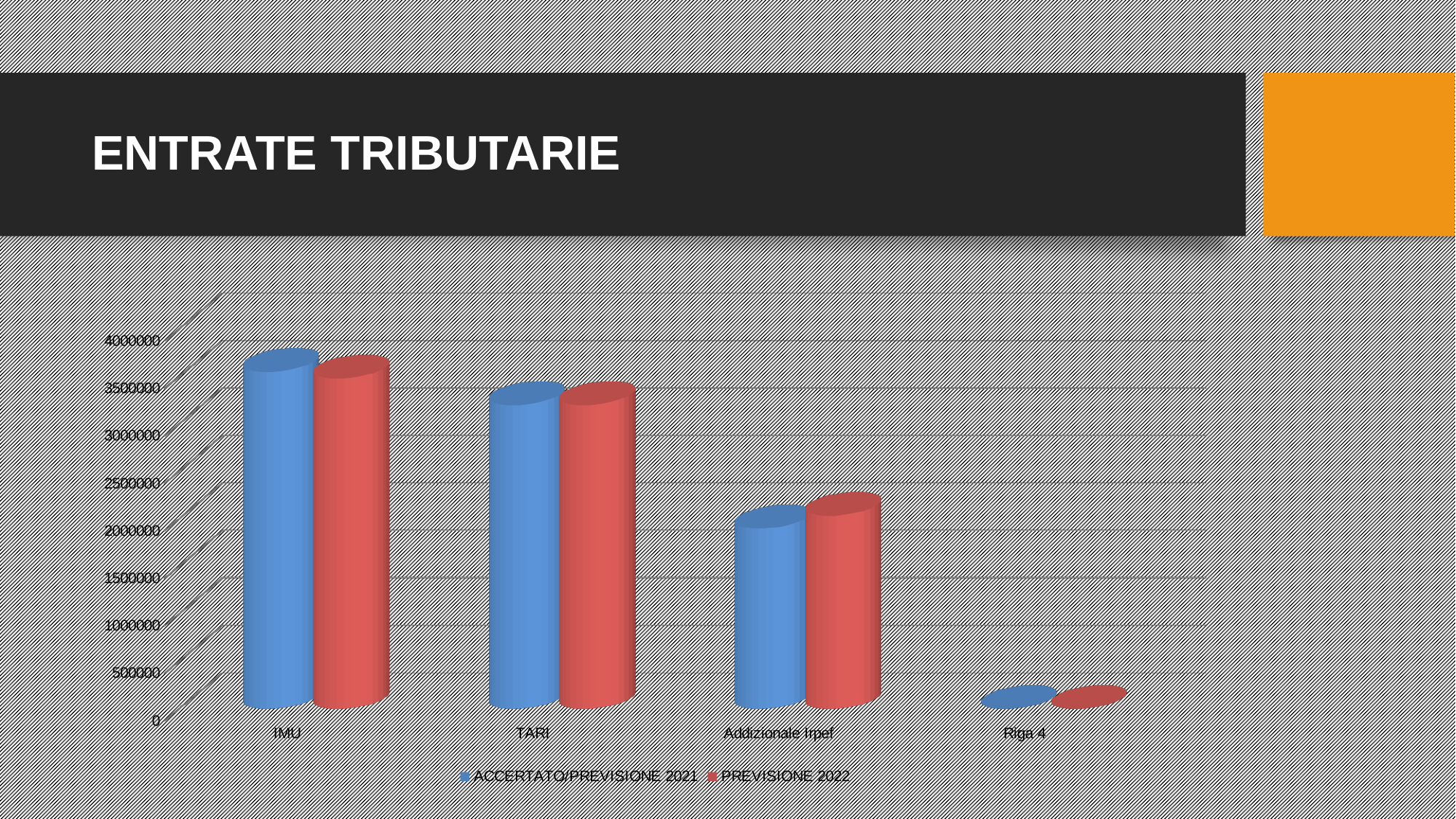
Is the PREVISIONE 2022 value for TARI greater or less than 3000000? greater Is the ACCERTATO/PREVISIONE 2021 value for Addizionale Irpef greater or less than 2500000? less Which category has the highest value for the ACCERTATO/PREVISIONE 2021 series? IMU What kind of chart is shown on the slide? bar chart How many categories are shown on the x axis of the chart? 4 Which category has the lowest value for the PREVISIONE 2022 series? Riga 4 Is the PREVISIONE 2022 value for Addizionale Irpef greater or less than 1500000? greater For the ACCERTATO/PREVISIONE 2021 series, which is larger: IMU or Addizionale Irpef? IMU Which colour represents the ACCERTATO/PREVISIONE 2021 series in the chart? blue What is the title of the slide containing the chart? ENTRATE TRIBUTARIE How many series does the chart legend list? 2